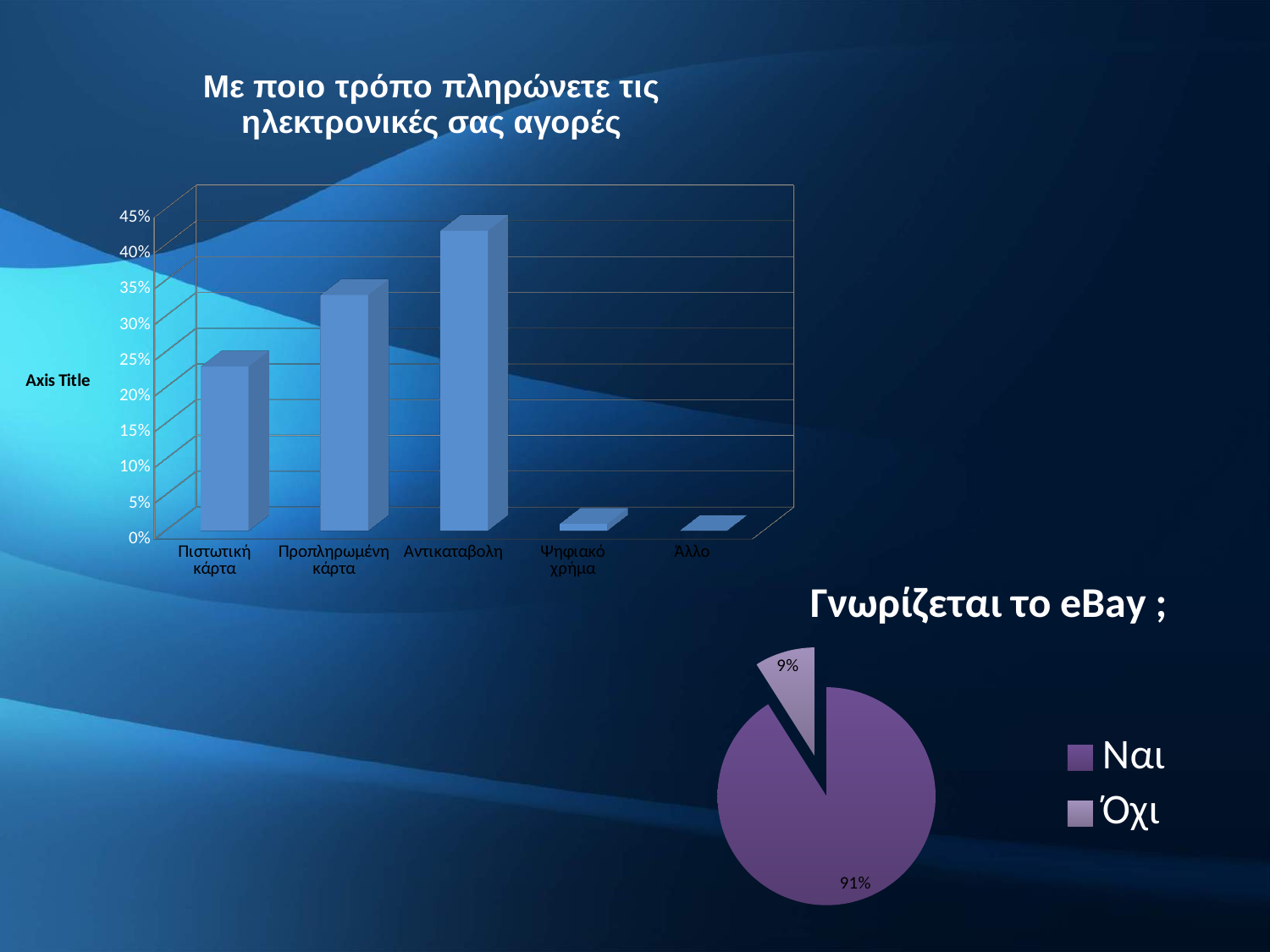
In the chart titled "Γνωρίζεται το eBay ;", what is the difference between the Ναι and Όχι slices? 82% How many categories are shown on the x axis of the chart titled "Με ποιο τρόπο πληρώνετε τις ηλεκτρονικές σας αγορές"? 5 How many entries does the legend of the chart titled "Γνωρίζεται το eBay ;" list? 2 In the chart titled "Με ποιο τρόπο πληρώνετε τις ηλεκτρονικές σας αγορές", is the value for Προπληρωμένη κάρτα greater or less than 25%? greater What kind of chart is the chart titled "Γνωρίζεται το eBay ;"? pie chart In the chart titled "Με ποιο τρόπο πληρώνετε τις ηλεκτρονικές σας αγορές", which category has the highest value? Αντικαταβολη In the chart titled "Γνωρίζεται το eBay ;", what is the value for Όχι? 9% What kind of chart is the chart titled "Με ποιο τρόπο πληρώνετε τις ηλεκτρονικές σας αγορές"? bar chart In the chart titled "Με ποιο τρόπο πληρώνετε τις ηλεκτρονικές σας αγορές", is the value for Αντικαταβολη greater or less than 35%? greater In the chart titled "Με ποιο τρόπο πληρώνετε τις ηλεκτρονικές σας αγορές", which is larger: Προπληρωμένη κάρτα or Αντικαταβολη? Αντικαταβολη In the chart titled "Με ποιο τρόπο πληρώνετε τις ηλεκτρονικές σας αγορές", is the value for Πιστωτική κάρτα greater or less than 30%? less In the chart titled "Γνωρίζεται το eBay ;", what share does Ναι have? 91%